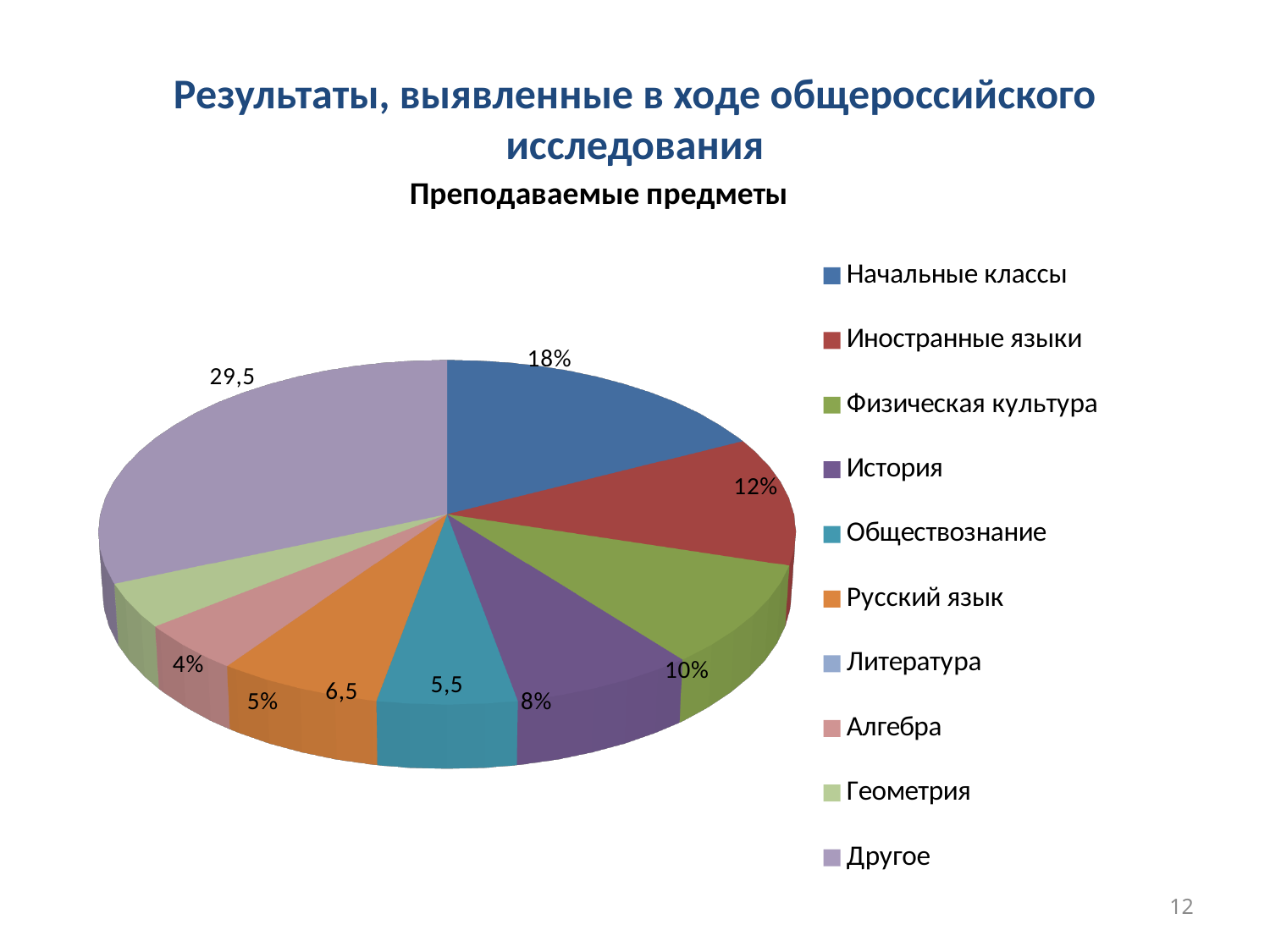
What is the title of the chart? Преподаваемые предметы What value is shown for Иностранные языки? 12% What kind of chart is shown on the slide? pie chart Which category has the largest slice of the pie? Другое What value is shown for Русский язык? 6,5 Which is larger, the slice for Начальные классы or the slice for Иностранные языки? Начальные классы What is the difference between the values for Начальные классы and Иностранные языки? 6% How many entries does the chart legend list? 10 What share of the pie is labelled for Начальные классы? 18% What value is shown for История? 8% What value is shown for Другое? 29,5 What value is shown for Физическая культура? 10%